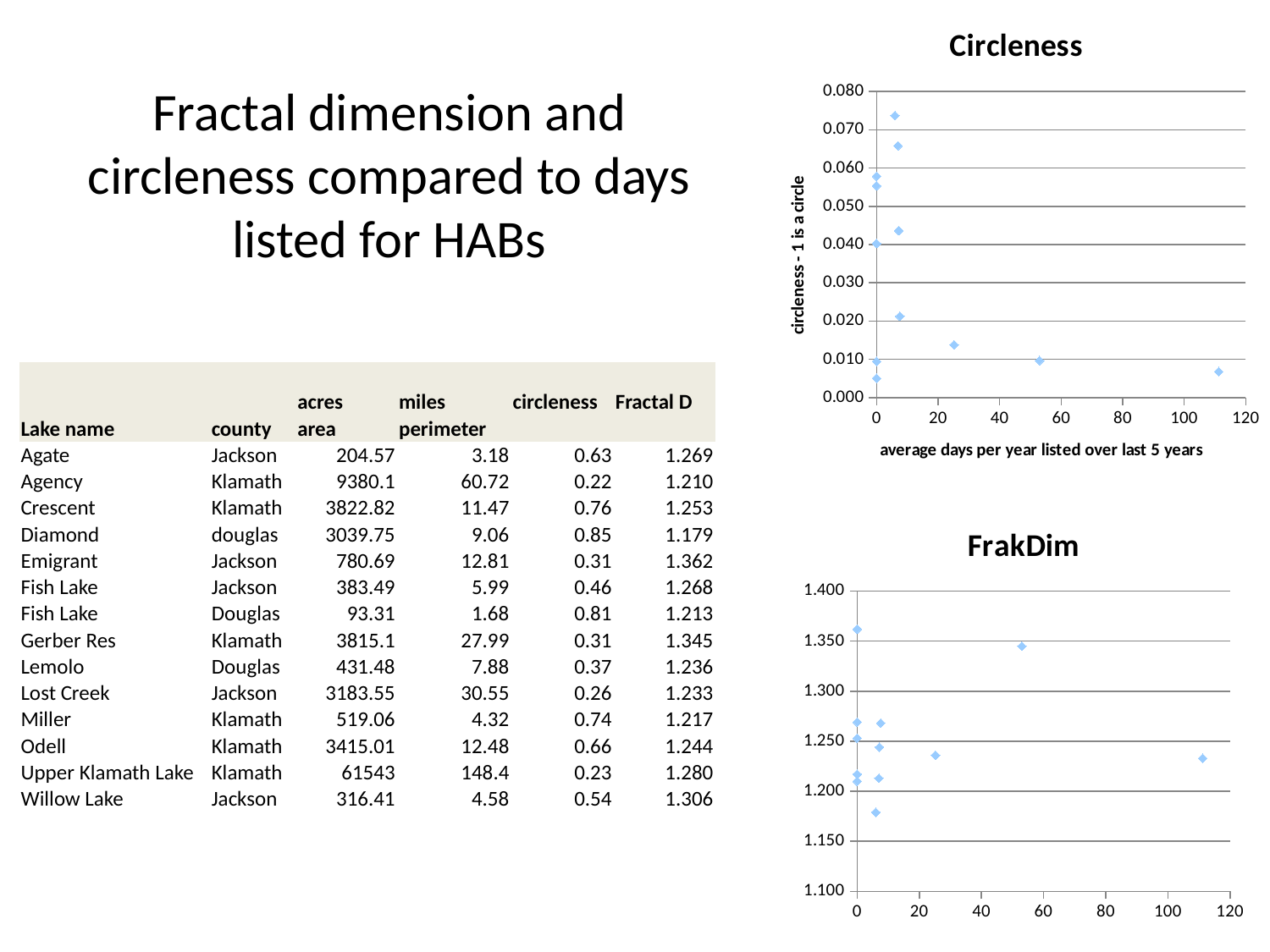
In the Circleness chart, do the circleness values generally rise or fall as the average days listed increases? fall What is the title of the lower chart on the slide? FrakDim What is the x-axis label of the Circleness chart? average days per year listed over last 5 years In the Circleness chart, is the highest plotted circleness value greater or less than 0.070? greater In the FrakDim chart, is the value for the point at about 110 days greater or less than 1.250? less In the FrakDim chart, is the lowest plotted value greater or less than 1.200? less What kind of chart is the FrakDim chart? scatter chart What kind of chart is the Circleness chart? scatter chart